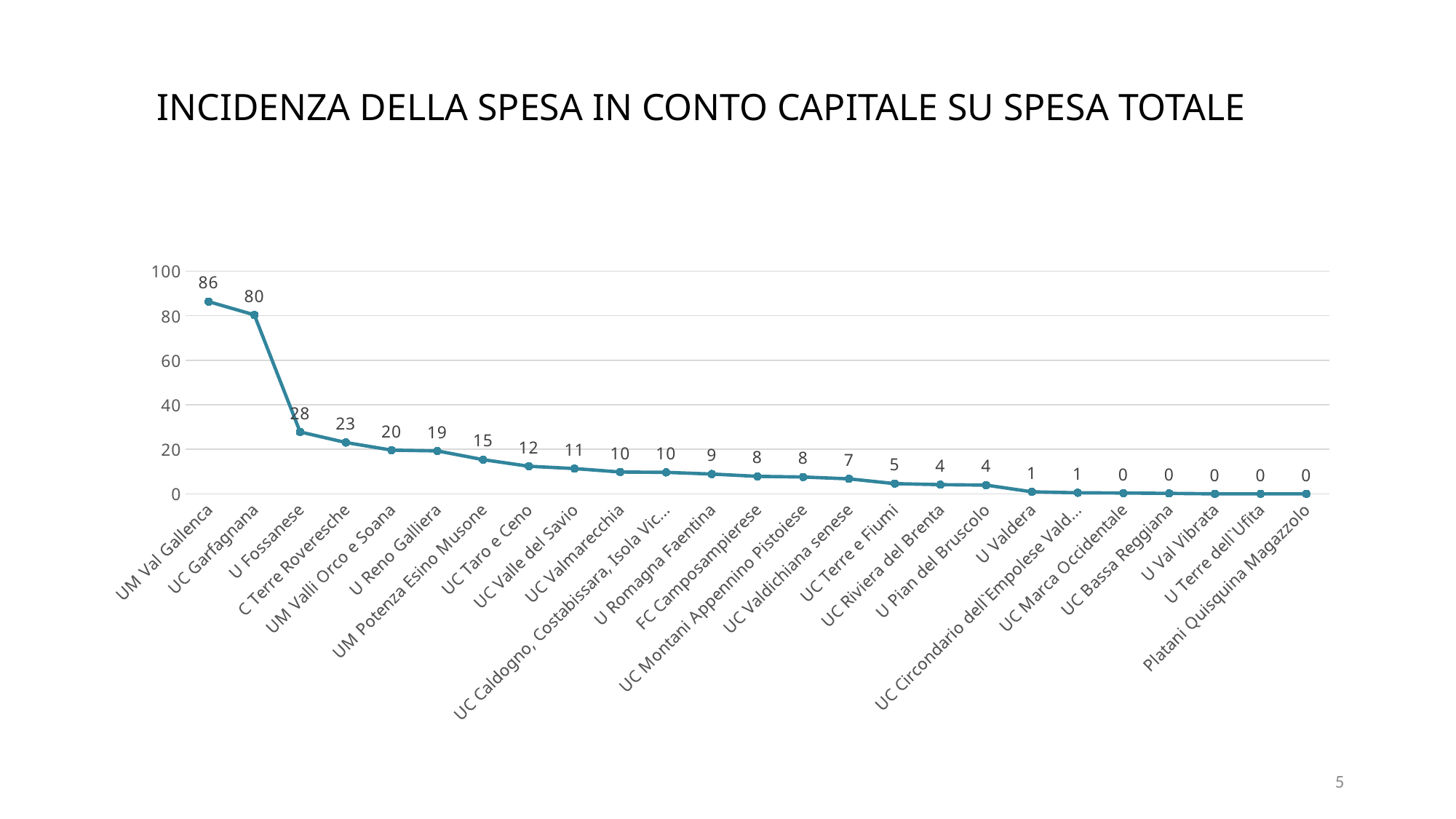
What is the value for U Fossanese? 28 Which category has the highest value? UM Val Gallenca Is the value for UC Garfagnana greater or less than 60? greater What is the value for UC Terre e Fiumi? 5 Do the values rise or fall from left to right along the x axis? fall What is the difference between the values for C Terre Roveresche and U Reno Galliera? 4 What is the value for UC Taro e Ceno? 12 How many data points are plotted on the chart? 25 What is the difference between the values for UM Val Gallenca and UC Garfagnana? 6 What kind of chart is shown on the slide? line chart What is the value for UM Val Gallenca? 86 Which is larger, the value for UC Garfagnana or the value for U Fossanese? UC Garfagnana